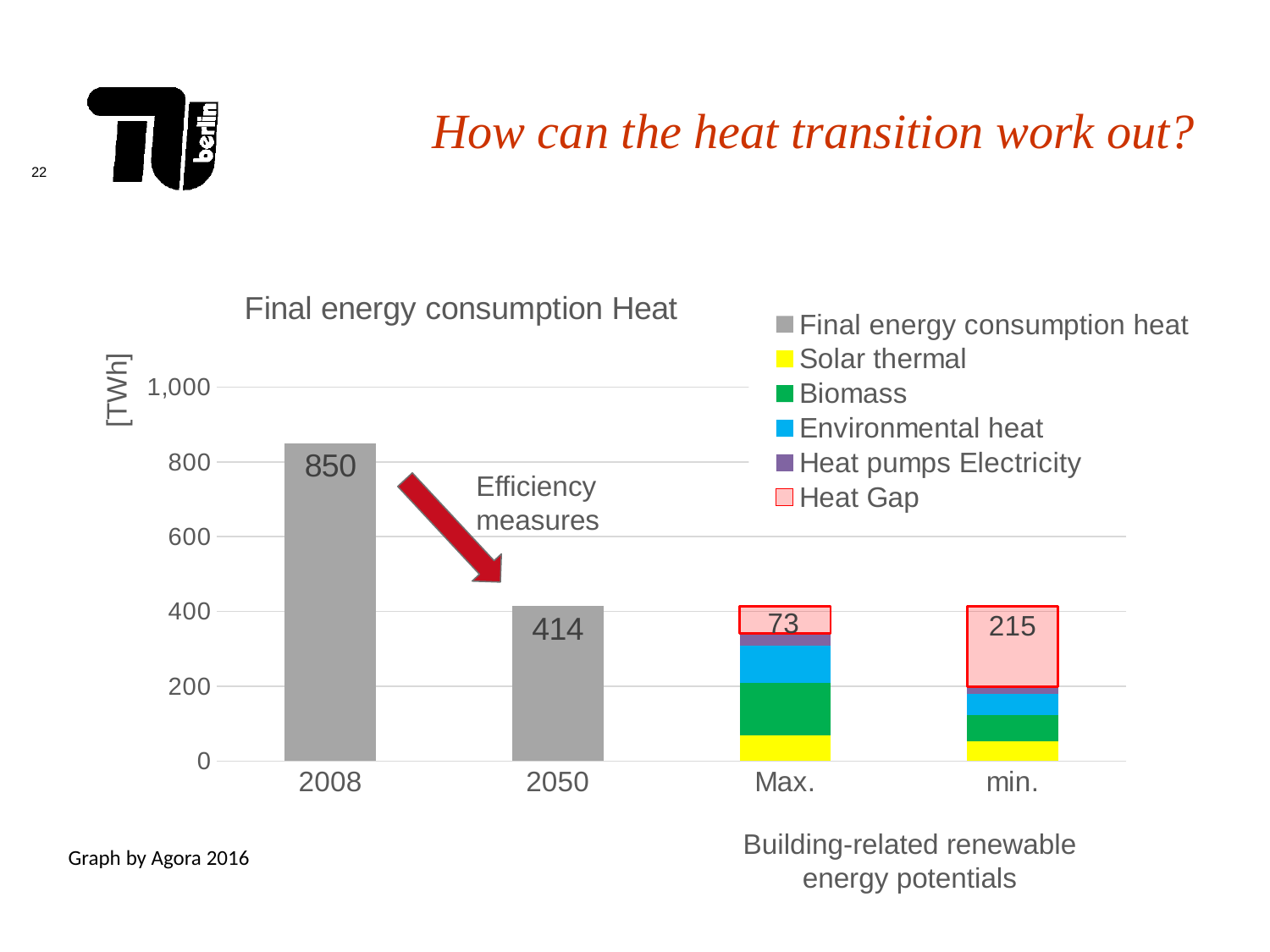
By how much does the final energy consumption heat value fall from 2008 to 2050? 436 What is the difference between the Heat Gap values of the min. and Max. bars? 142 How many categories are shown on the x axis of the chart? 4 What is the value for 2050 in the Final energy consumption Heat chart? 414 How many series does the legend list? 6 Is the Solar thermal segment of the Max. bar greater or less than 200? less What is the value for 2008 in the Final energy consumption Heat chart? 850 What is the Heat Gap value for the Max. bar? 73 Which bar has the larger Heat Gap, Max. or min.? min. What is the Heat Gap value for the min. bar? 215 What unit is shown on the y axis of the chart? [TWh] Which category has the tallest bar in the chart? 2008